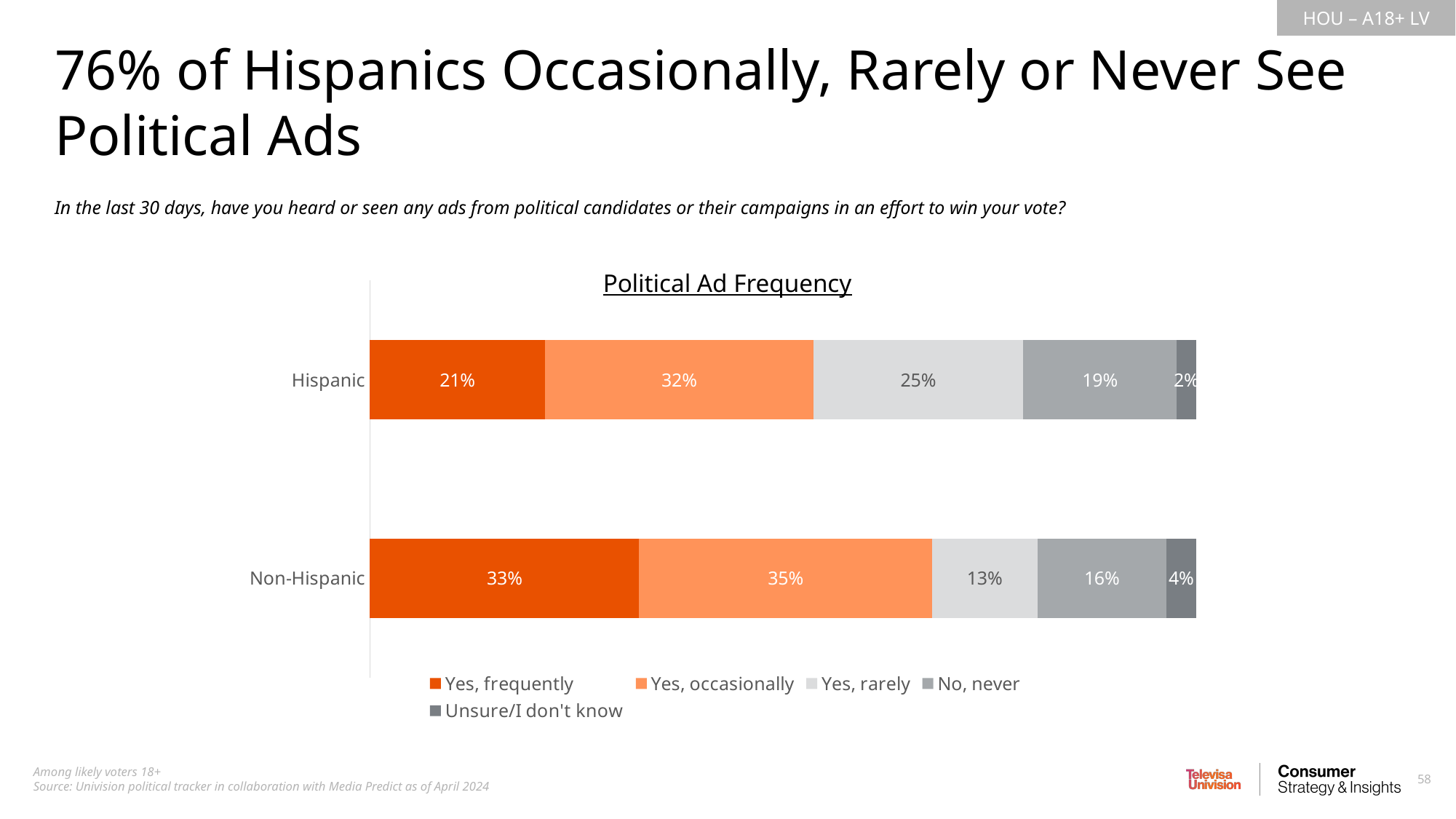
What is the difference between the 'Yes, rarely' values for Hispanic and Non-Hispanic respondents? 12 percentage points What is the 'Unsure/I don't know' value for Hispanic respondents? 2% What is the 'No, never' value for Non-Hispanic respondents? 16% Which group has the higher 'Yes, frequently' value, Hispanic or Non-Hispanic? Non-Hispanic What percentage of Non-Hispanic respondents said they see political ads occasionally? 35% Which response category has the largest share among Hispanic respondents? Yes, occasionally What percentage of Hispanic respondents said they see political ads frequently? 21% How many series does the legend list? 5 Which response category has the smallest share among Non-Hispanic respondents? Unsure/I don't know What is the 'Yes, rarely' value for Hispanic respondents? 25% What is the difference between the 'Yes, frequently' values for Non-Hispanic and Hispanic respondents? 12 percentage points What type of chart is shown on the slide? Stacked bar chart